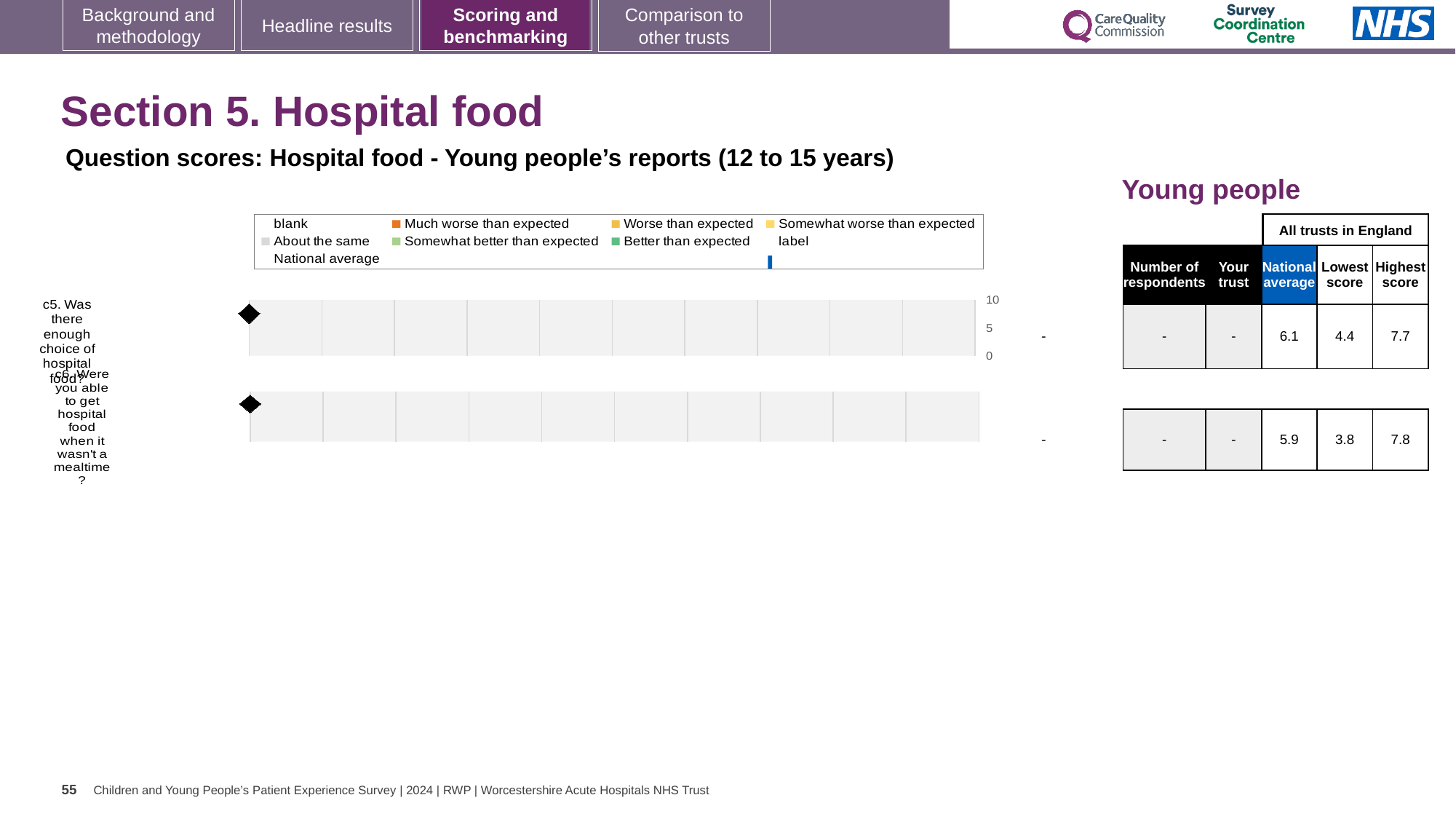
In the table beside the chart, what is the national average for c5 'Was there enough choice of hospital food?' 6.1 What colour does the legend use for 'Much worse than expected'? orange In the table beside the chart, what is the highest score for c6 'Were you able to get hospital food when it wasn't a mealtime?' 7.8 In the table beside the chart, which question has the higher national average, c5 or c6? c5 What is the highest value shown on the chart's axis? 10 In the table beside the chart, what is the difference between the highest and lowest score for c6? 4.0 In the table beside the chart, what is the lowest score for c5 'Was there enough choice of hospital food?' 4.4 How many questions (categories) are plotted on the chart? 2 What kind of chart is shown on the slide? bar chart